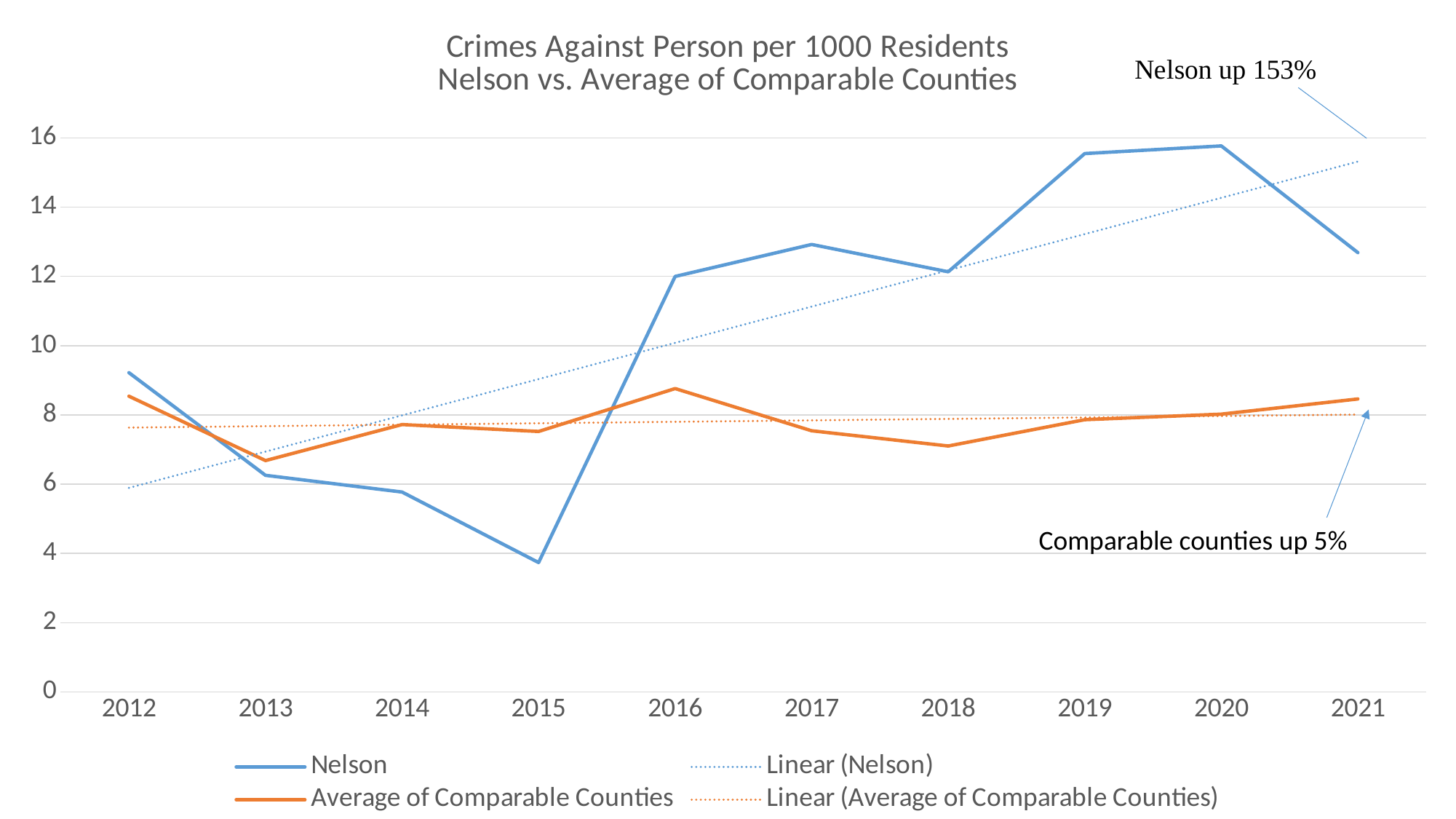
What kind of chart is shown on the slide? line chart In 2015, which is larger: Nelson or Average of Comparable Counties? Average of Comparable Counties According to the annotation, by what percentage are comparable counties up? 5% Is the Average of Comparable Counties value for 2018 greater or less than 8? less Is the Nelson value for 2015 greater or less than 4? less According to the annotation, by what percentage is Nelson up? 153% Is the Nelson value for 2016 greater or less than 10? greater How many series does the legend list? 4 How many years are plotted along the x axis? 10 In 2019, which is larger: Nelson or Average of Comparable Counties? Nelson In which year is the Nelson value lowest? 2015